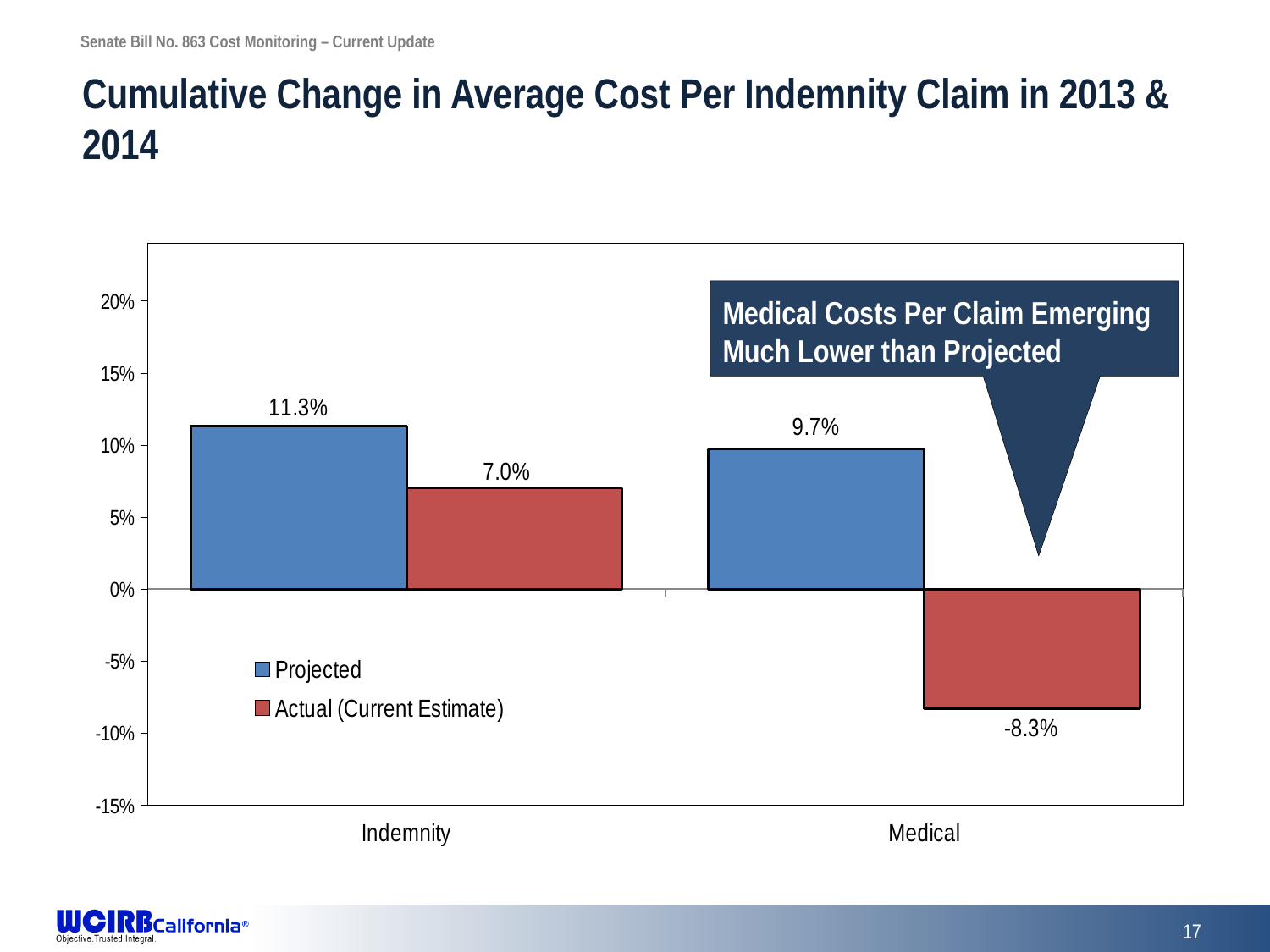
Which category has the highest Projected value? Indemnity What is the Actual (Current Estimate) value for Medical? -8.3% How many categories are shown on the x axis? 2 How many series does the legend list? 2 Which category has the lowest Actual (Current Estimate) value? Medical Which is larger for Medical: the Projected value or the Actual (Current Estimate) value? Projected What kind of chart is shown on the slide? bar chart What is the Projected value for Medical? 9.7% What is the Actual (Current Estimate) value for Indemnity? 7.0% Is the Actual (Current Estimate) value for Medical greater or less than 0%? less What is the Projected value for Indemnity? 11.3% What is the difference between the Projected and Actual (Current Estimate) values for Indemnity? 4.3%